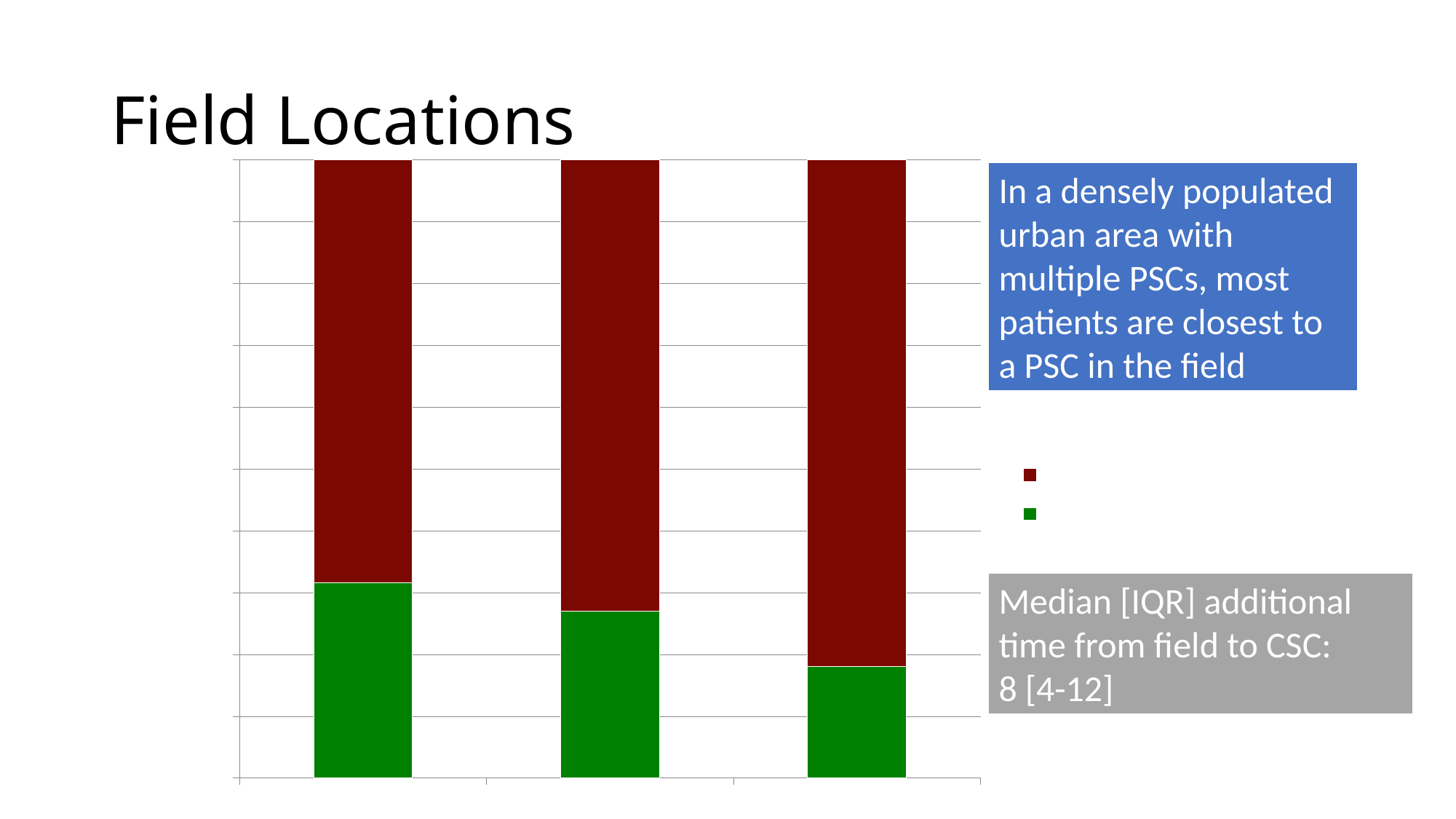
Does the green segment rise or fall from the leftmost bar to the rightmost bar? fall Which bar has the smallest green segment? the rightmost bar Which bar has the largest green segment, the leftmost or the rightmost? leftmost What two colours are used for the series in the chart? dark red and green What kind of chart is shown on the slide? stacked bar chart Does the dark red segment rise or fall from the leftmost bar to the rightmost bar? rise How many bars are plotted in the chart? 3 How many series does the chart's legend list? 2 Which colour segment sits at the bottom of each stacked bar? green In each bar, which segment is larger, the dark red or the green? dark red